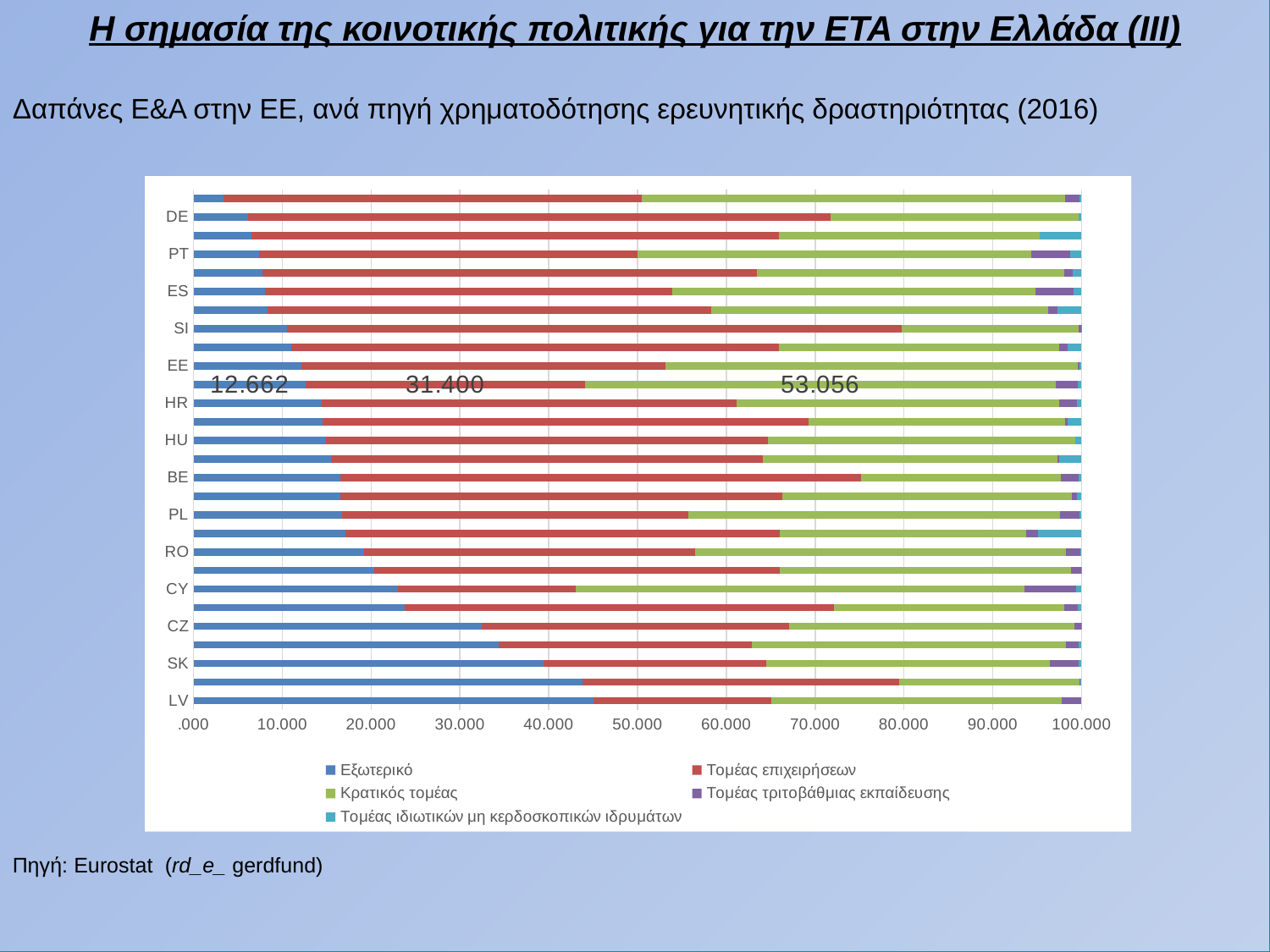
What is the printed data label for the Εξωτερικό (blue) segment on the only bar that carries data labels? 12.662 What kind of chart is shown on the slide? Stacked bar chart What is the printed data label for the Κρατικός τομέας (green) segment on the bar that carries data labels? 53.056 Which has the larger Εξωτερικό (blue) segment, LV or DE? LV Which has the larger Τομέας επιχειρήσεων (red) segment, SI or CY? SI Is the Εξωτερικό (blue) value for DE greater or less than 10.000? less Is the Εξωτερικό (blue) value for LV greater or less than 40.000? greater Is the Εξωτερικό (blue) value for CZ greater or less than 30.000? greater How many series does the chart legend list? 5 What is the highest value shown on the horizontal axis of the chart? 100.000 What is the printed data label for the Τομέας επιχειρήσεων (red) segment on the bar that carries data labels? 31.400 Moving down the chart from DE at the top to LV at the bottom, does the Εξωτερικό (blue) segment generally get larger or smaller? larger